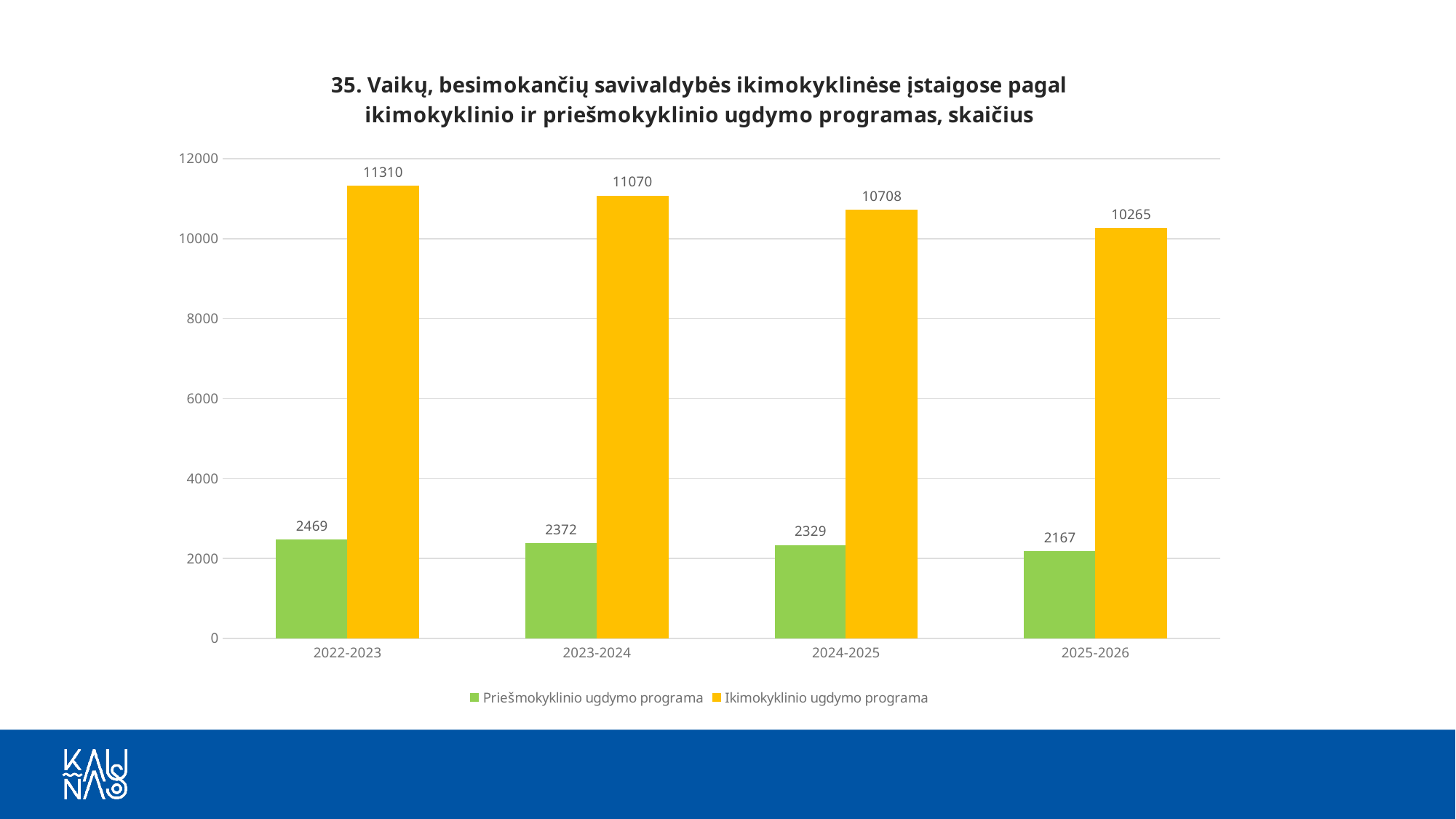
What is the value for Priešmokyklinio ugdymo programa in 2025-2026? 2167 In which school year is the Priešmokyklinio ugdymo programa value highest? 2022-2023 What is the value for Ikimokyklinio ugdymo programa in 2024-2025? 10708 What kind of chart is shown on the slide? bar chart How many school years are shown on the x axis? 4 How many series does the legend list? 2 What is the difference between the Priešmokyklinio ugdymo programa values for 2023-2024 and 2024-2025? 43 In which school year is the Ikimokyklinio ugdymo programa value lowest? 2025-2026 Do the Ikimokyklinio ugdymo programa values rise or fall from 2022-2023 to 2025-2026? fall What is the difference between the Ikimokyklinio ugdymo programa values for 2022-2023 and 2025-2026? 1045 What is the value for Ikimokyklinio ugdymo programa in 2022-2023? 11310 Which is larger in 2023-2024: Priešmokyklinio ugdymo programa or Ikimokyklinio ugdymo programa? Ikimokyklinio ugdymo programa